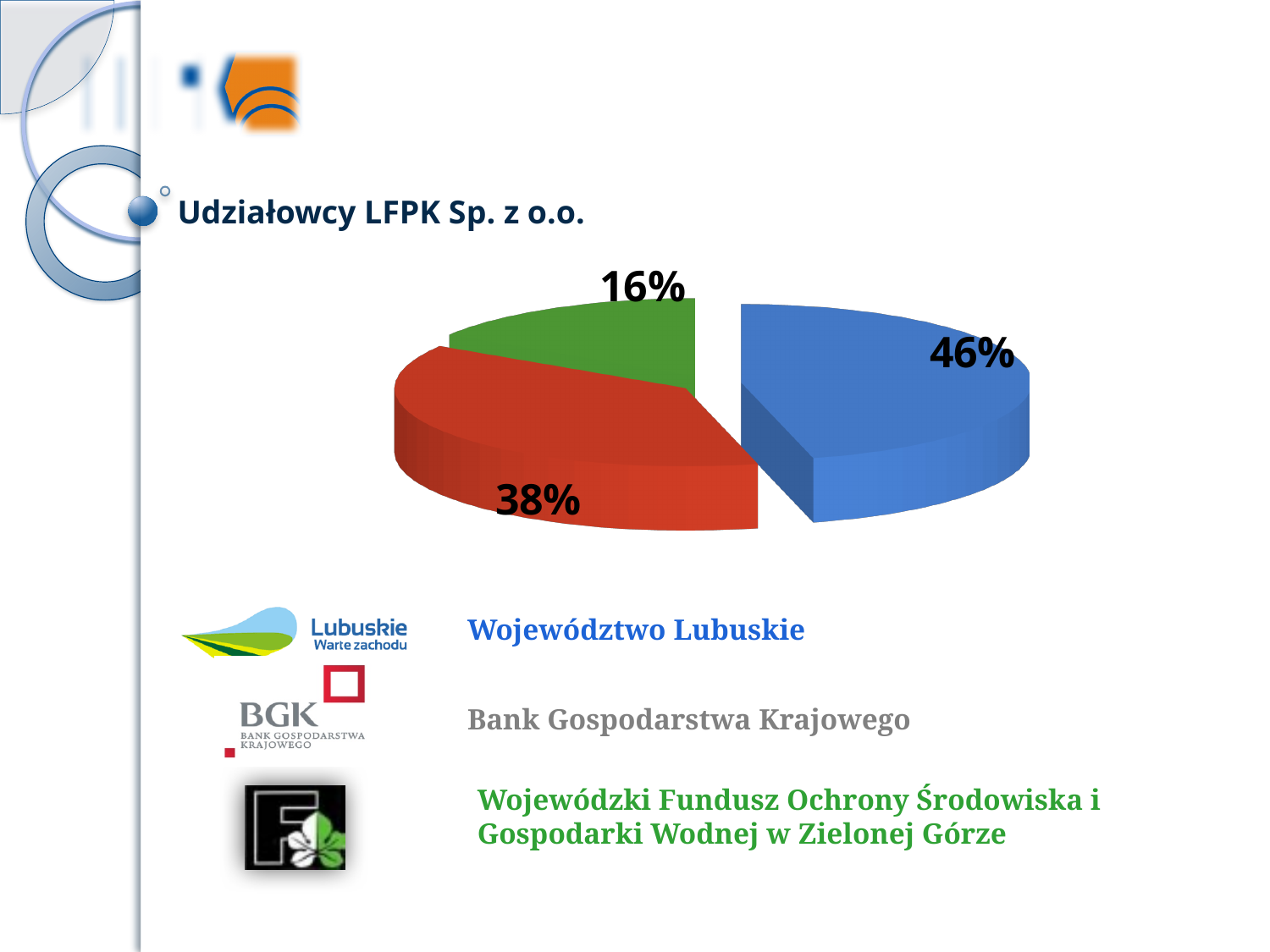
What percentage is shown for the blue slice of the pie chart? 46% Which slice of the pie chart is the smallest? the green slice (16%) What is the difference between the blue slice and the red slice of the pie chart? 8% What percentage is shown for the red slice of the pie chart? 38% What percentage is shown for the green slice of the pie chart? 16% What kind of chart is shown on the slide? pie chart What is the title of the slide above the pie chart? Udziałowcy LFPK Sp. z o.o. Which slice of the pie chart is the largest? the blue slice (46%) How many slices does the pie chart have? 3 What is the difference between the red slice and the green slice of the pie chart? 22% Which is larger in the pie chart, the red slice or the green slice? the red slice How many shareholder names are listed below the pie chart? 3